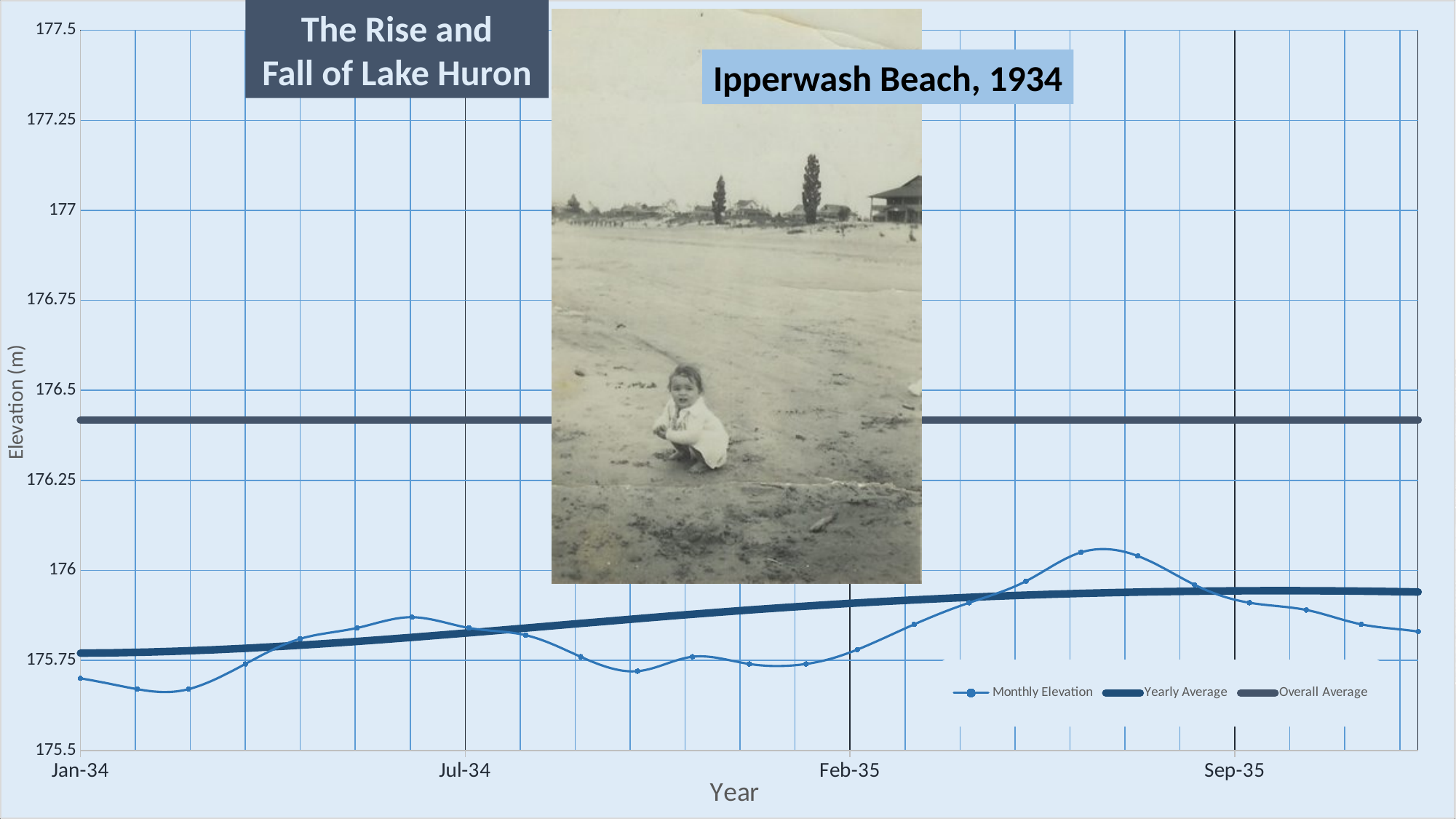
Is the Overall Average line greater or less than 176.25? greater What is the title of the chart? The Rise and Fall of Lake Huron What is the label on the vertical axis of the chart? Elevation (m) Is the Monthly Elevation value at Jan-34 greater or less than 175.75? less Does the Yearly Average line rise or fall from Jan-34 to Sep-35? rise Is the highest Monthly Elevation value on the chart greater or less than 176? greater What kind of chart is shown on the slide? line chart How many labelled tick marks are shown on the x axis? 4 How many series does the chart's legend list? 3 Which is higher on the chart, the Overall Average line or the Yearly Average line? Overall Average